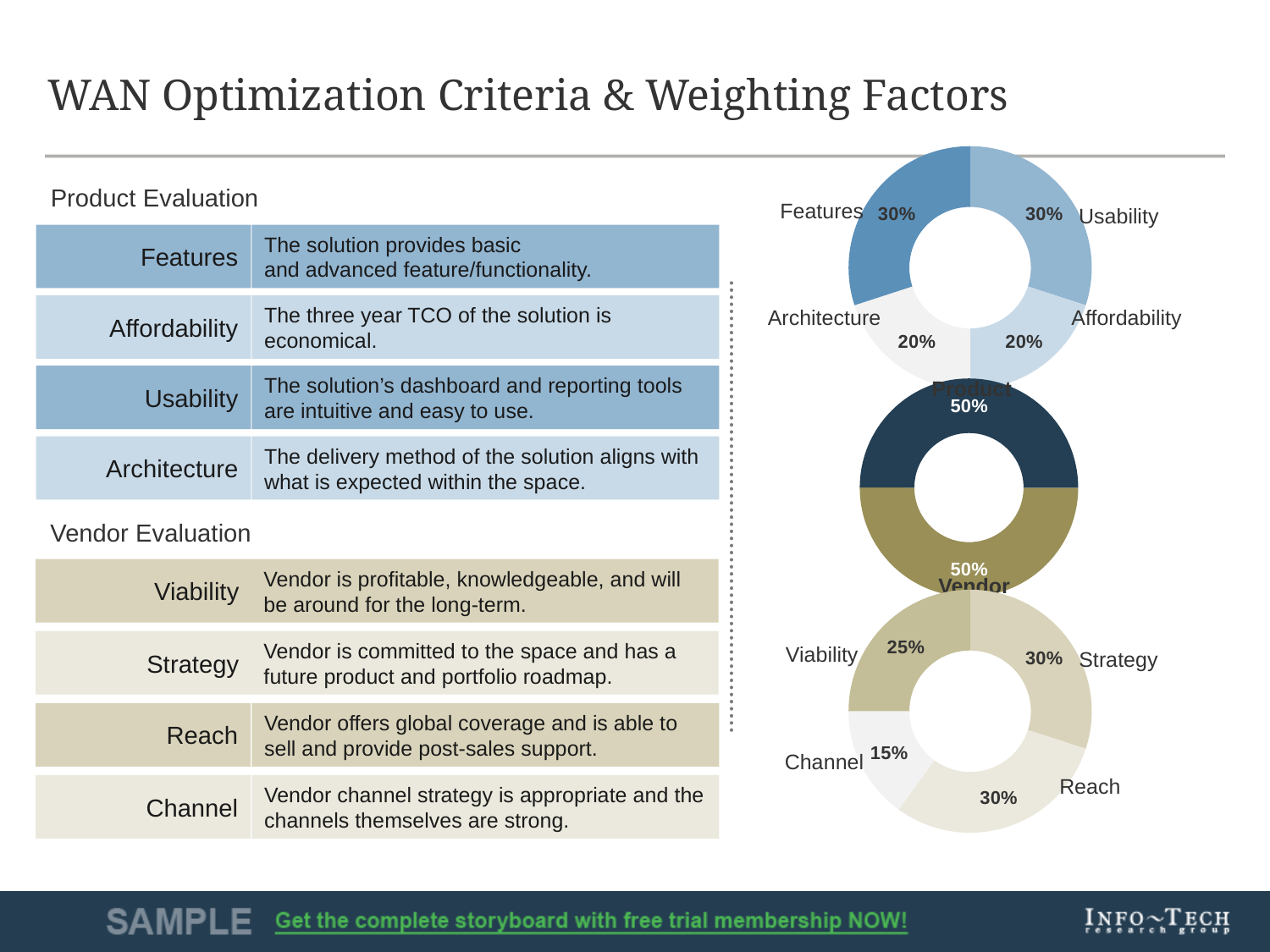
How many categories are shown in the top donut chart? 4 In the middle donut chart, what share is given to Product? 50% In the bottom donut chart, what is the difference between the Strategy weighting and the Channel weighting? 15% In the bottom donut chart, which category has the lowest weighting? Channel In the middle donut chart, what share is given to Vendor? 50% In the top donut chart, what is the difference between the Features weighting and the Affordability weighting? 10% In the top donut chart, what is the weighting for Architecture? 20% What type of chart is used to show the weighting factors on this slide? Donut (pie) chart In the top donut chart, which has the larger weighting, Usability or Affordability? Usability In the bottom donut chart, what is the weighting for Channel? 15% In the bottom donut chart, what is the weighting for Viability? 25% In the top donut chart, what is the weighting for Features? 30%